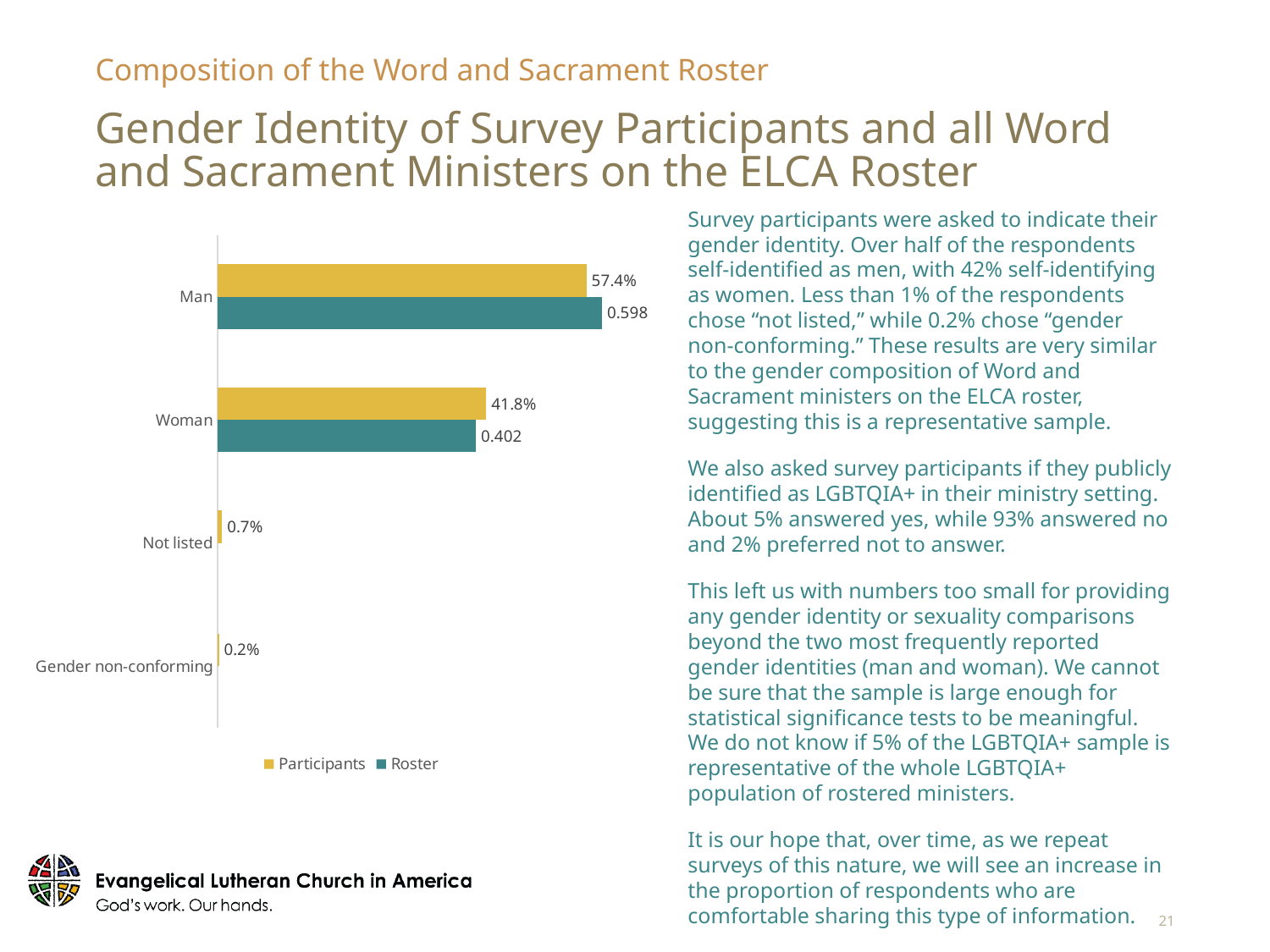
What is the Participants value for Gender non-conforming? 0.2% What is the Participants value for Man? 57.4% What is the Roster value for Woman? 0.402 What is the Roster value for Man? 0.598 What is the difference between the Participants values for Man and Woman? 15.6% Which category has the highest Participants value? Man What kind of chart is shown on the slide? Bar chart What is the Participants value for Woman? 41.8% Which category has the lowest Participants value? Gender non-conforming How many series does the legend list? 2 Which is larger, the Roster value for Man or the Roster value for Woman? Man What is the Participants value for Not listed? 0.7%